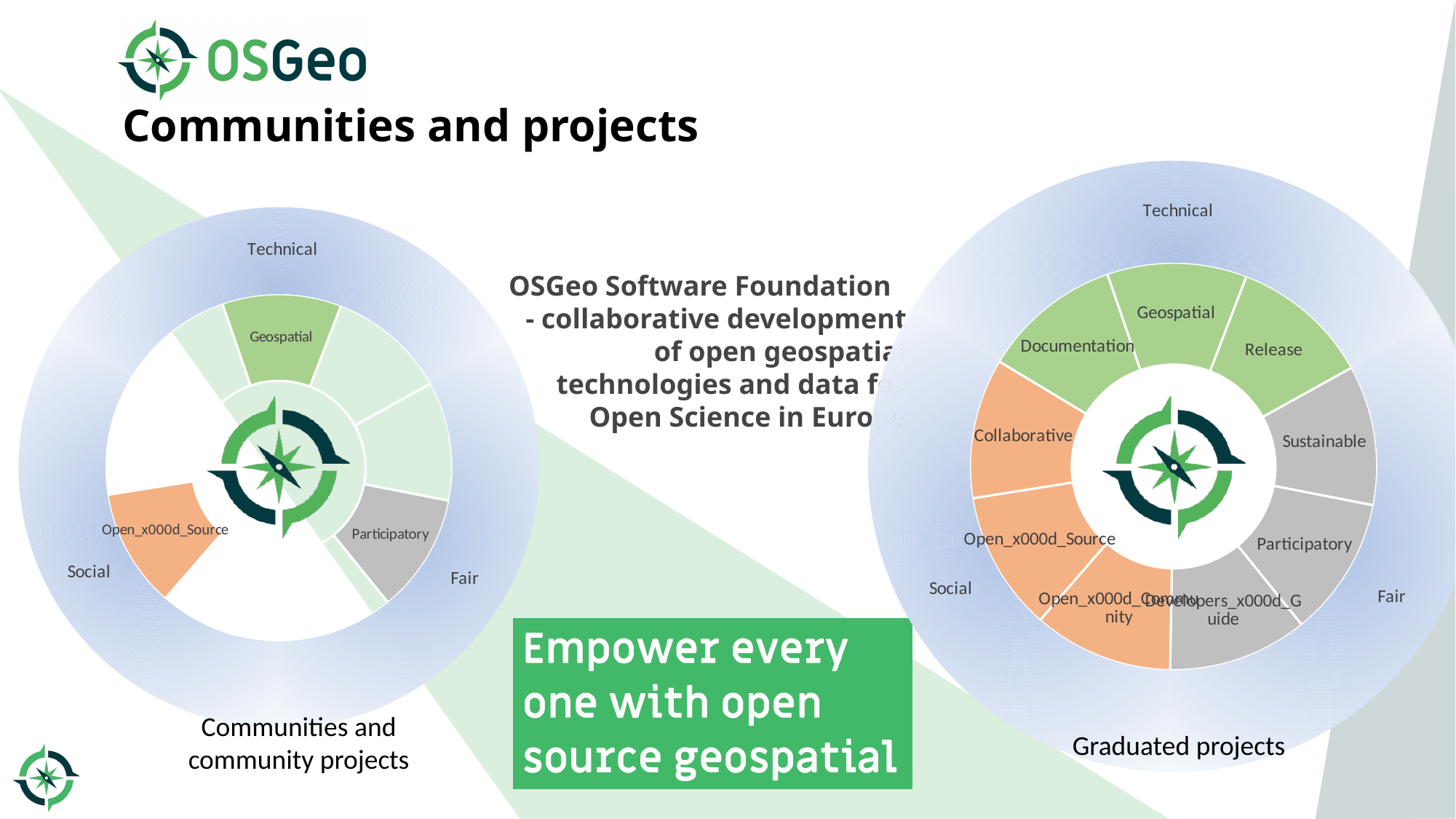
How many outer-ring group labels (Technical, Fair, Social) surround the 'Graduated projects' chart? 3 What is the caption under the left chart? Communities and community projects In the 'Graduated projects' chart, which segments are coloured orange? Collaborative, Open_x000d_Source, Open_x000d_Community Which chart has more labelled segments, 'Communities and community projects' or 'Graduated projects'? Graduated projects How many labelled segments does the 'Communities and community projects' chart have? 3 How many labelled segments does the 'Graduated projects' chart have? 9 In the 'Communities and community projects' chart, which segment is coloured grey? Participatory What is the caption under the right chart? Graduated projects What kind of chart is the 'Graduated projects' chart? doughnut chart